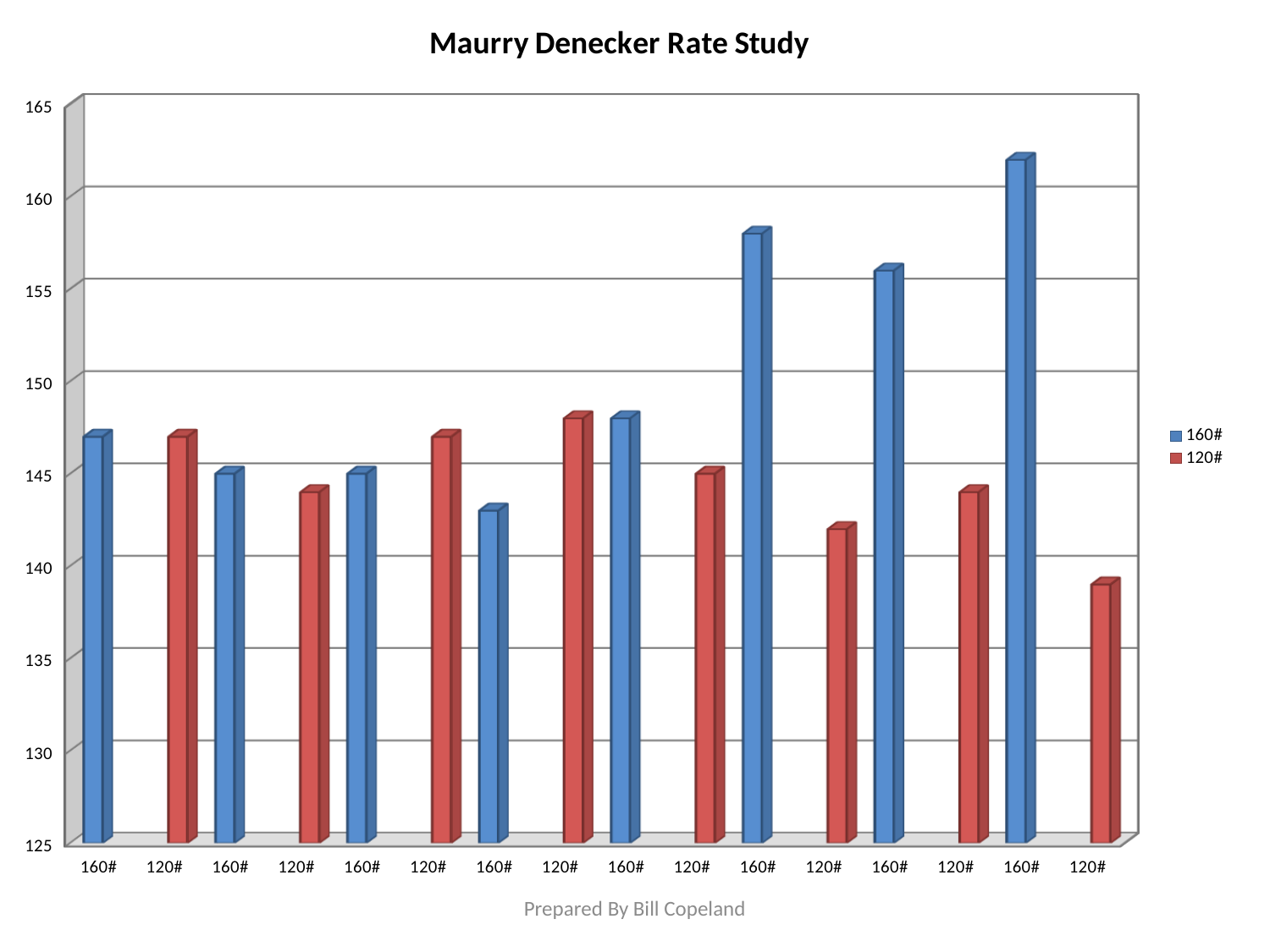
Which colour represents the 120# series in the legend? red What kind of chart is shown on the slide? bar chart Which is taller, the 15th bar or the 11th bar? the 15th bar Is the value of the 7th bar (160#) greater or less than 145? less Is the value of the last (16th) bar greater or less than 140? less How many bars are plotted in the chart? 16 Is the value of the 11th bar (160#) greater or less than 155? greater What is the title of the chart? Maurry Denecker Rate Study Which bar is the tallest in the chart? the 15th bar (160#) Which bar is the shortest in the chart? the last bar (120#) How many series does the legend list? 2